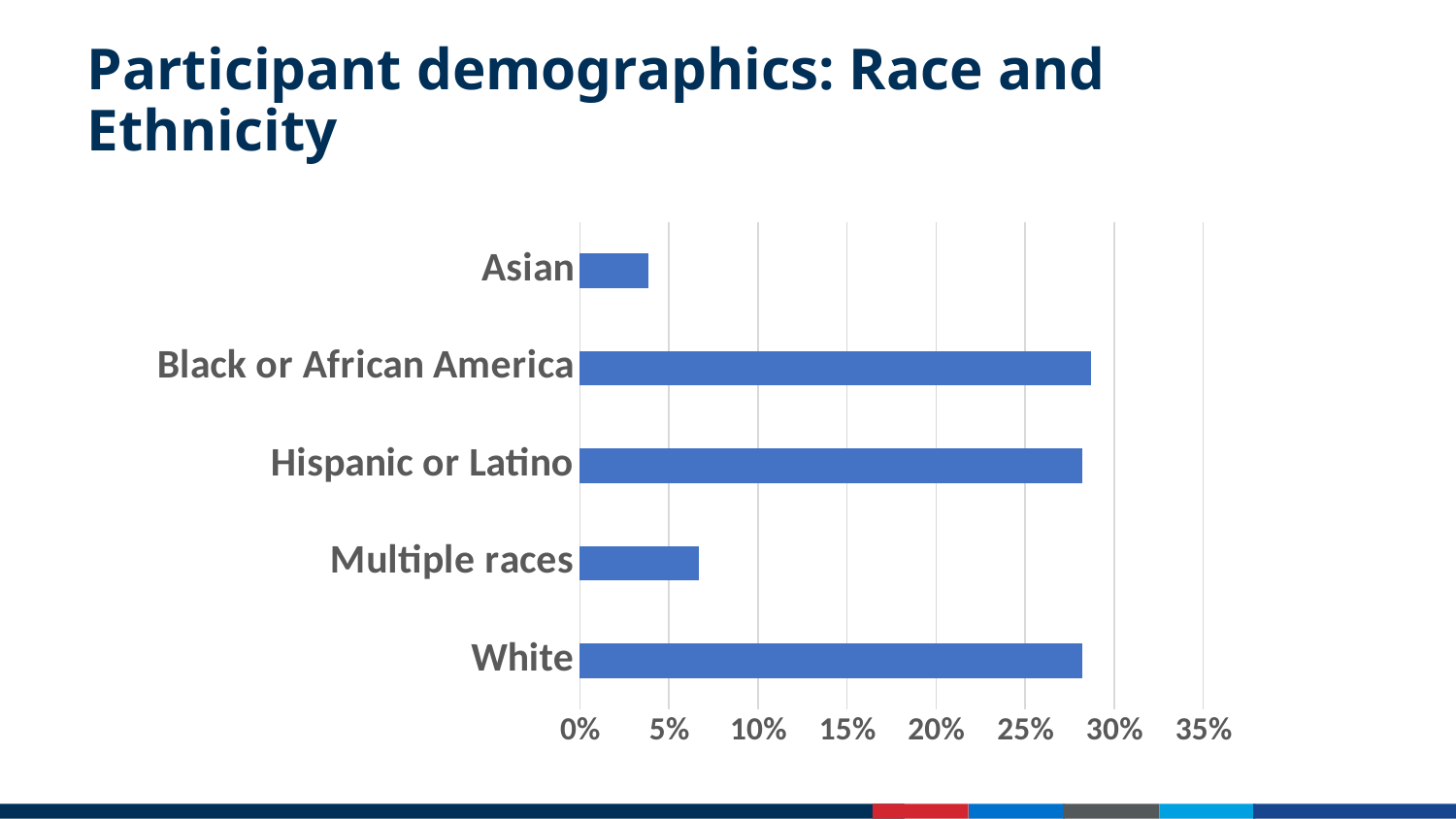
Which is larger, the value for Asian or the value for Multiple races? Multiple races Which category has the lowest value in the chart? Asian How many race/ethnicity categories are plotted in the chart? 5 Is the value for Black or African America greater or less than 25%? greater What is the title of the slide containing the chart? Participant demographics: Race and Ethnicity Is the value for Asian greater or less than 5%? less Is the value for Hispanic or Latino greater or less than 30%? less What kind of chart is shown on the slide? bar chart What is the highest value shown on the chart's horizontal axis? 35%